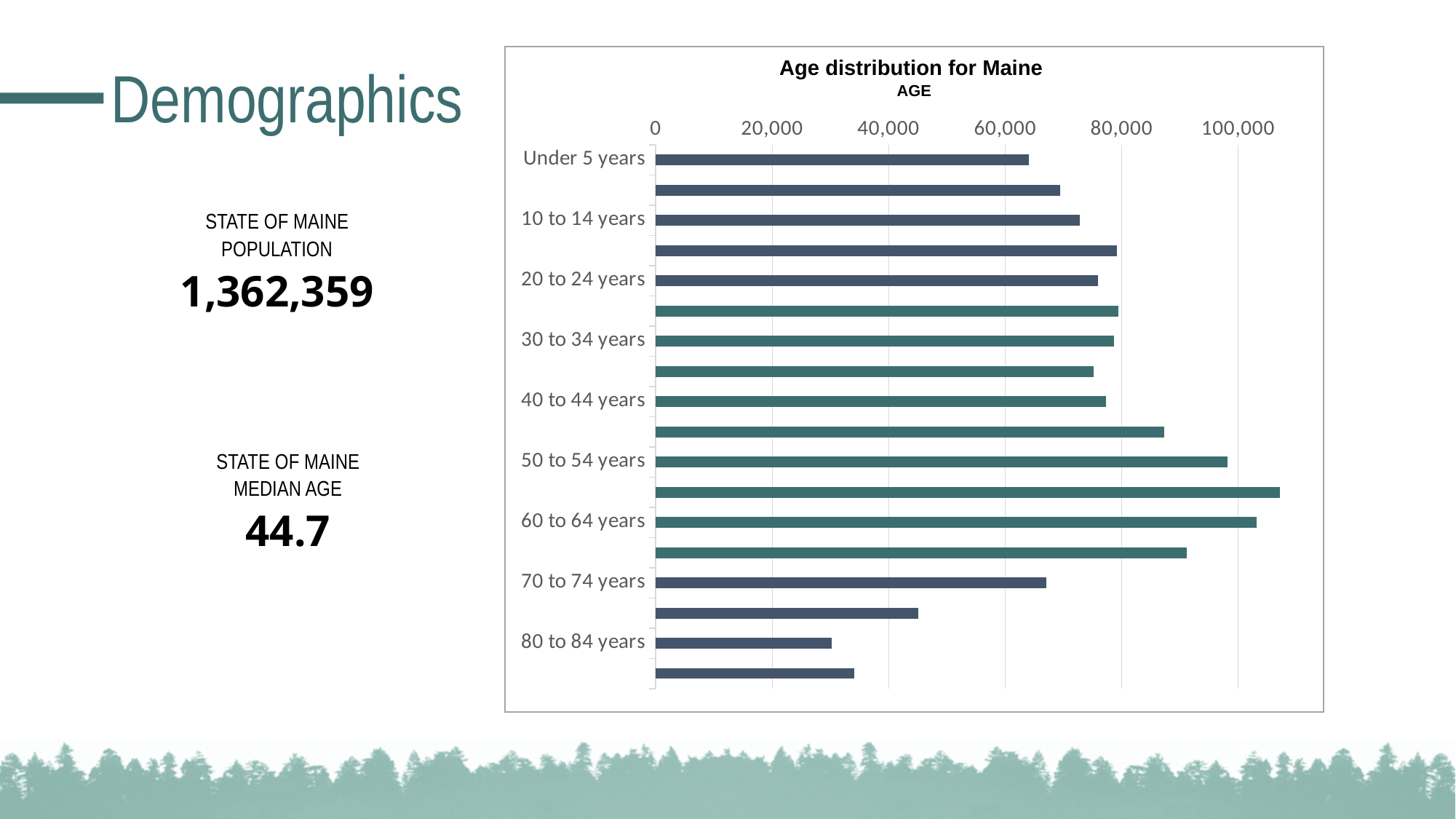
How many age group labels are shown on the vertical axis of the chart? 9 Which is larger, the value for 50 to 54 years or the value for 70 to 74 years? 50 to 54 years Is the value for 10 to 14 years greater or less than 80,000? less Is the value for 60 to 64 years greater or less than 100,000? greater Is the value for 80 to 84 years greater or less than 40,000? less What is the title of the chart? Age distribution for Maine Which age group has the shortest bar in the chart? 80 to 84 years What kind of chart is shown on the slide? bar chart Which is larger, the value for 60 to 64 years or the value for Under 5 years? 60 to 64 years